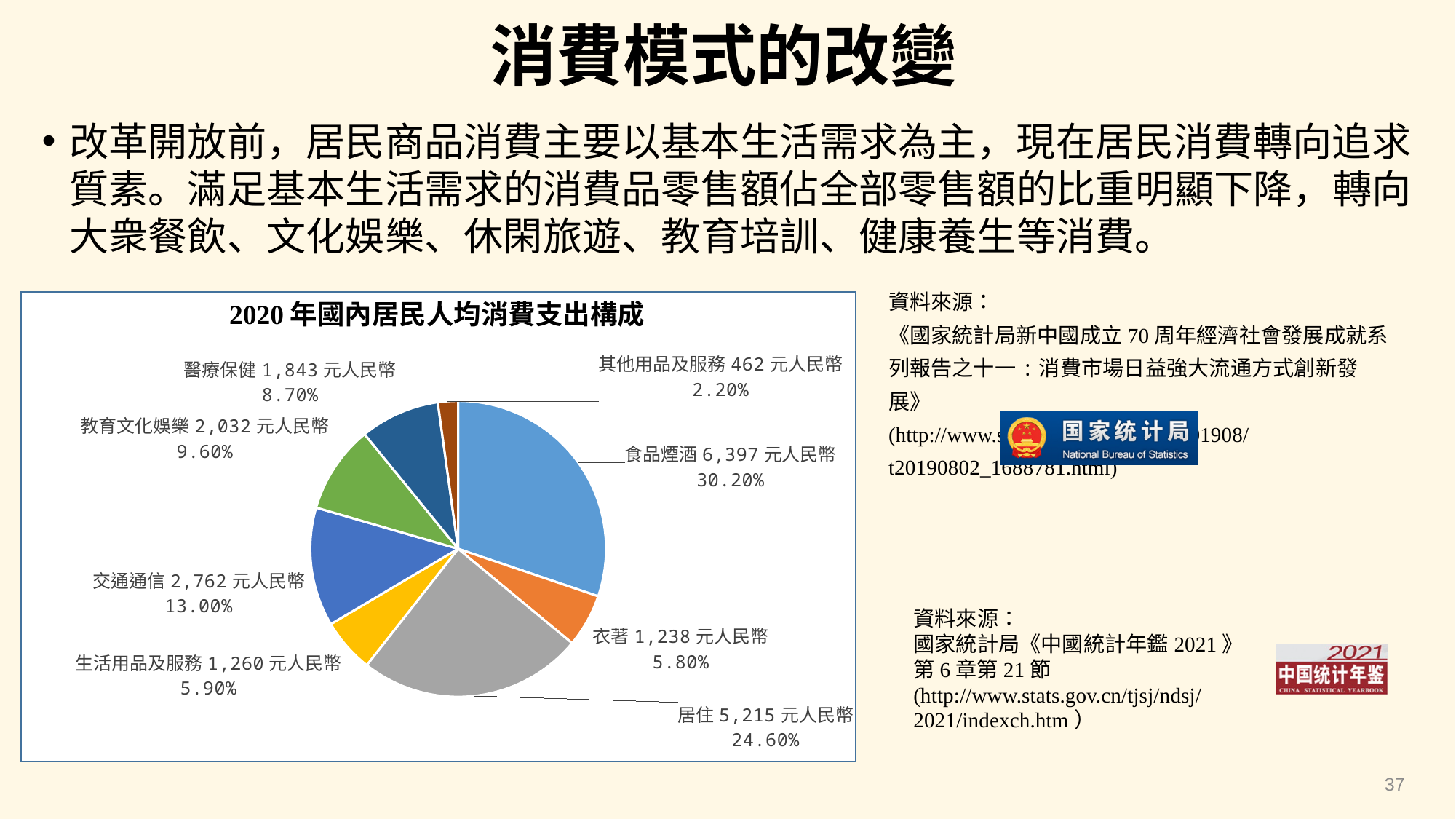
What share of the pie does 食品煙酒 represent? 30.20% What is the value for 食品煙酒? 6,397 元人民幣 What is the value for 交通通信? 2,762 元人民幣 What is the title of the chart? 2020 年國內居民人均消費支出構成 Which is larger, the value for 教育文化娛樂 or 醫療保健? 教育文化娛樂 Which category has the largest value? 食品煙酒 How many categories does the pie chart show? 8 What type of chart is shown on the slide? pie chart What share of the pie does 醫療保健 represent? 8.70% What is the value for 居住? 5,215 元人民幣 What is the difference between the values for 食品煙酒 and 居住? 1,182 元人民幣 Which category has the smallest value? 其他用品及服務